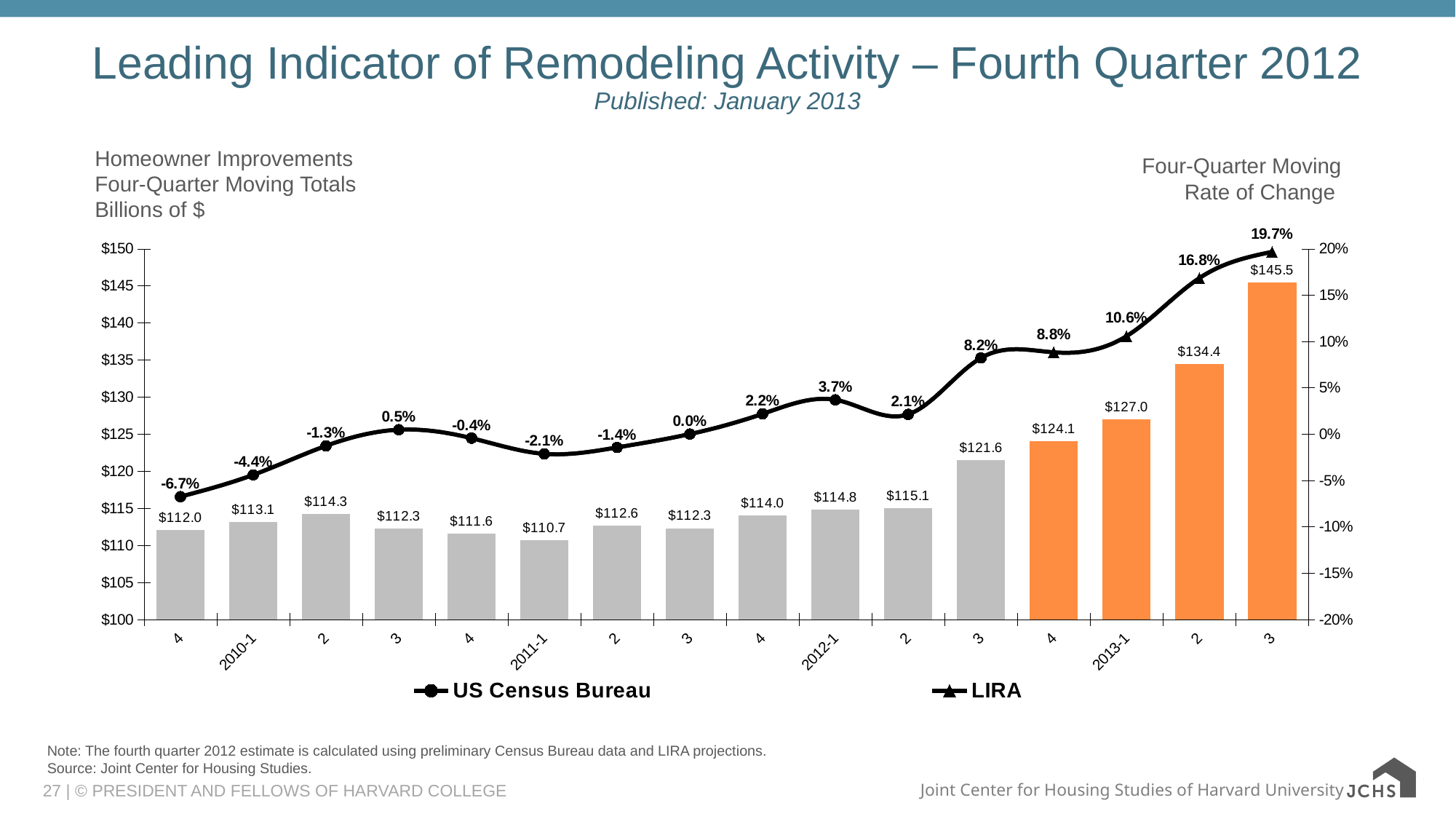
What is the four-quarter moving total of homeowner improvements for 2013-1? $127.0 Which quarter has the highest four-quarter moving total, and what is its value? The last bar (2013 quarter 3), $145.5 Do the four-quarter moving totals rise or fall across the orange bars from 2012 quarter 4 to 2013 quarter 3? Rise What is the four-quarter moving rate of change shown for 2012-1? 3.7% How many bars (quarters) are plotted in the chart? 16 Which quarter has the lowest four-quarter moving total? 2011-1 ($110.7) Which is larger, the four-quarter moving total for 2012-1 or for 2011-1? 2012-1 What is the lowest four-quarter moving rate of change shown on the line? -6.7% What is the four-quarter moving total of homeowner improvements for 2011-1? $110.7 What is the highest four-quarter moving rate of change shown on the line? 19.7% How many series does the legend list? 2 What is the difference between the four-quarter moving totals for 2013-1 and 2012-1? $12.2